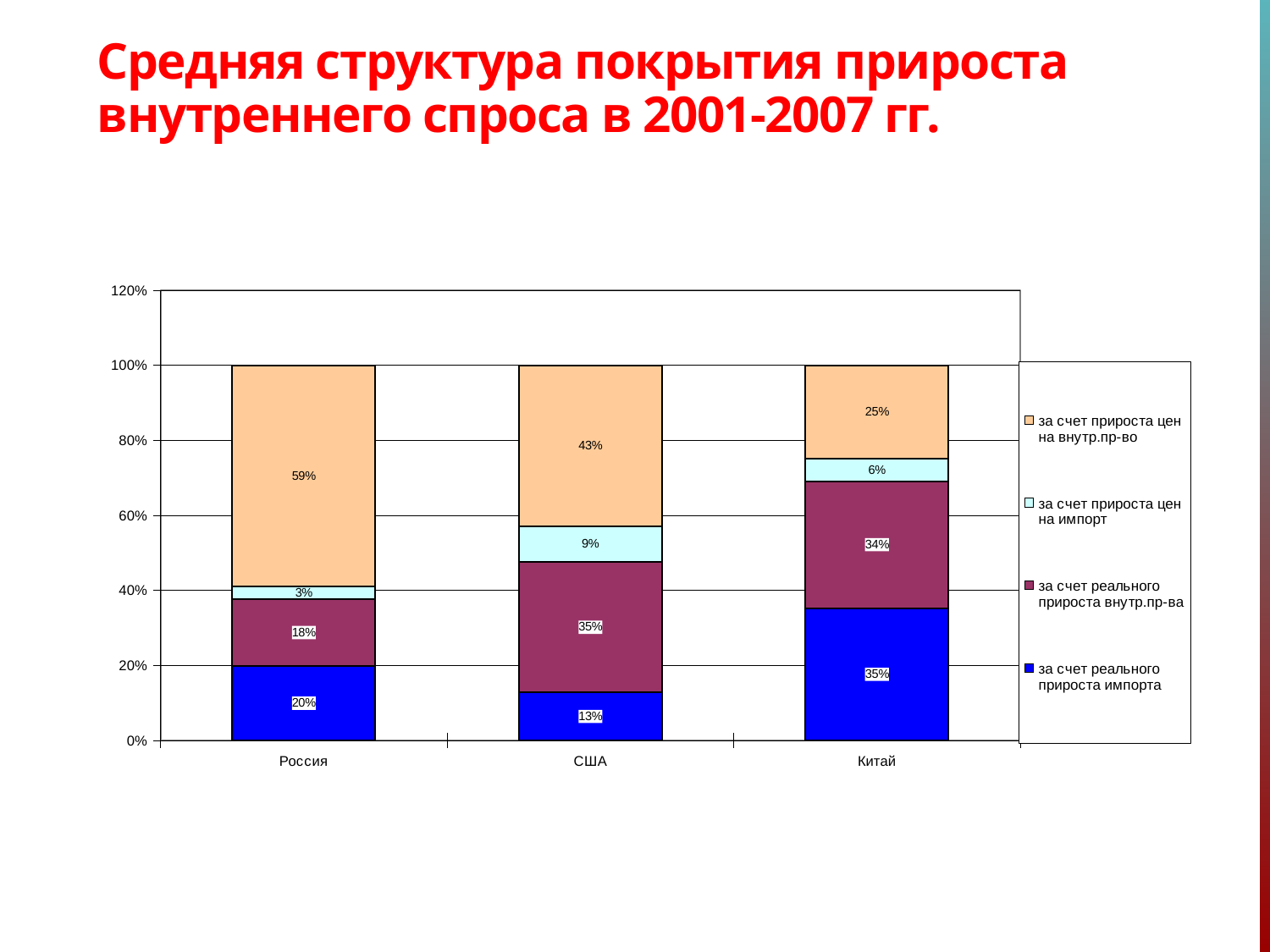
What kind of chart is shown on the slide? stacked bar chart What is the value for Россия in the series 'за счет прироста цен на импорт'? 3% Which is larger: the 'за счет прироста цен на импорт' value for США or for Китай? США What is the value for США in the series 'за счет реального прироста внутр.пр-ва'? 35% Which country has the lowest value in the series 'за счет реального прироста импорта'? США How many countries are shown on the x axis of the chart? 3 How many series does the legend list? 4 What is the total of the stacked bar for Китай? 100% Which country has the highest value in the series 'за счет прироста цен на внутр.пр-во'? Россия What is the value for Китай in the series 'за счет реального прироста импорта'? 35% What is the difference between the 'за счет прироста цен на внутр.пр-во' values for Россия and Китай? 34% What is the value for Россия in the series 'за счет прироста цен на внутр.пр-во'? 59%